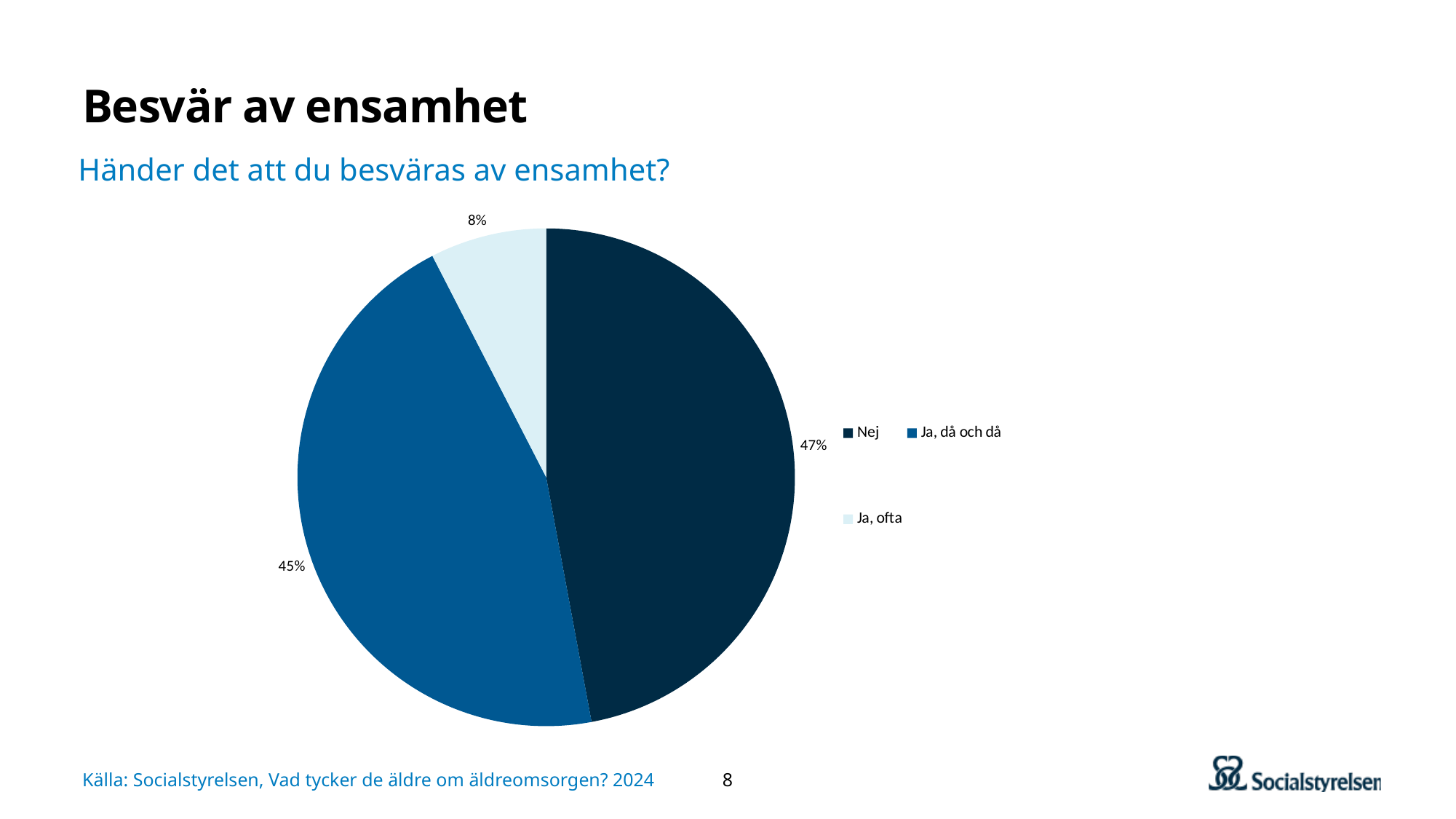
What is the difference in percentage points between "Ja, då och då" and "Ja, ofta"? 37 percentage points Which is larger, the share for "Ja, då och då" or the share for "Ja, ofta"? Ja, då och då What percentage of respondents answered "Ja, då och då"? 45% Which response has the largest share of the pie? Nej What percentage of respondents answered "Ja, ofta"? 8% Which response has the smallest share of the pie? Ja, ofta What percentage of respondents answered "Nej"? 47% How many slices does the pie chart have? 3 What kind of chart is shown on the slide? Pie chart What is the combined share of the two "Ja" responses ("Ja, då och då" and "Ja, ofta")? 53% What is the difference in percentage points between "Nej" and "Ja, då och då"? 2 percentage points What question is the pie chart answering, according to the subtitle? Händer det att du besväras av ensamhet?